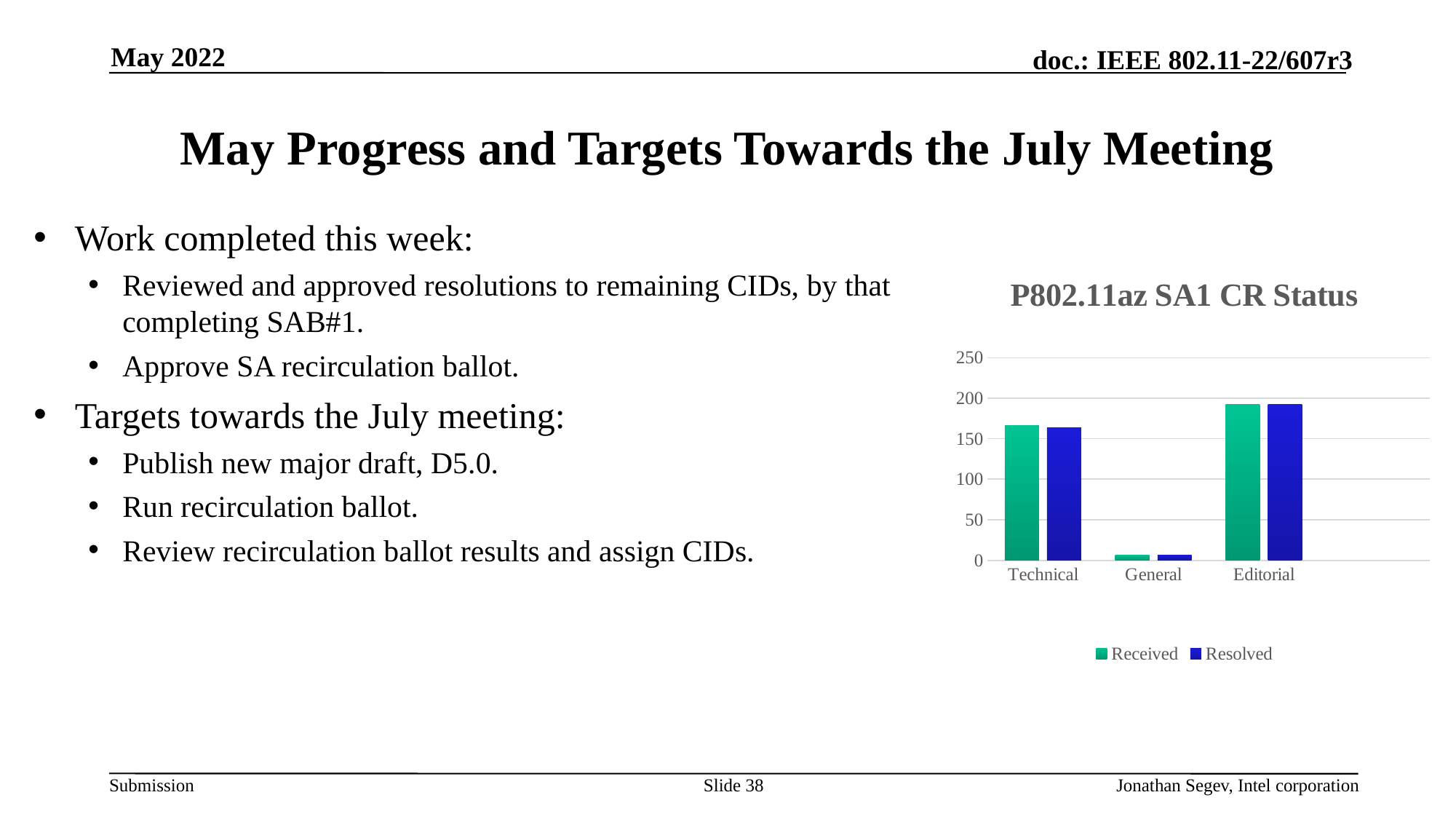
Is the Received value for General greater or less than 50? less Which is larger, the Received value for Editorial or the Received value for Technical? Editorial Is the Resolved value for Technical greater or less than 200? less What is the title of the chart on the slide? P802.11az SA1 CR Status Which category has the lowest Resolved value? General What kind of chart is shown on the slide? bar chart How many categories are shown on the x axis of the chart? 3 How many series does the chart's legend list? 2 What are the two series named in the chart's legend? Received and Resolved Is the Resolved value for Editorial greater or less than 150? greater Which category has the highest Received value? Editorial